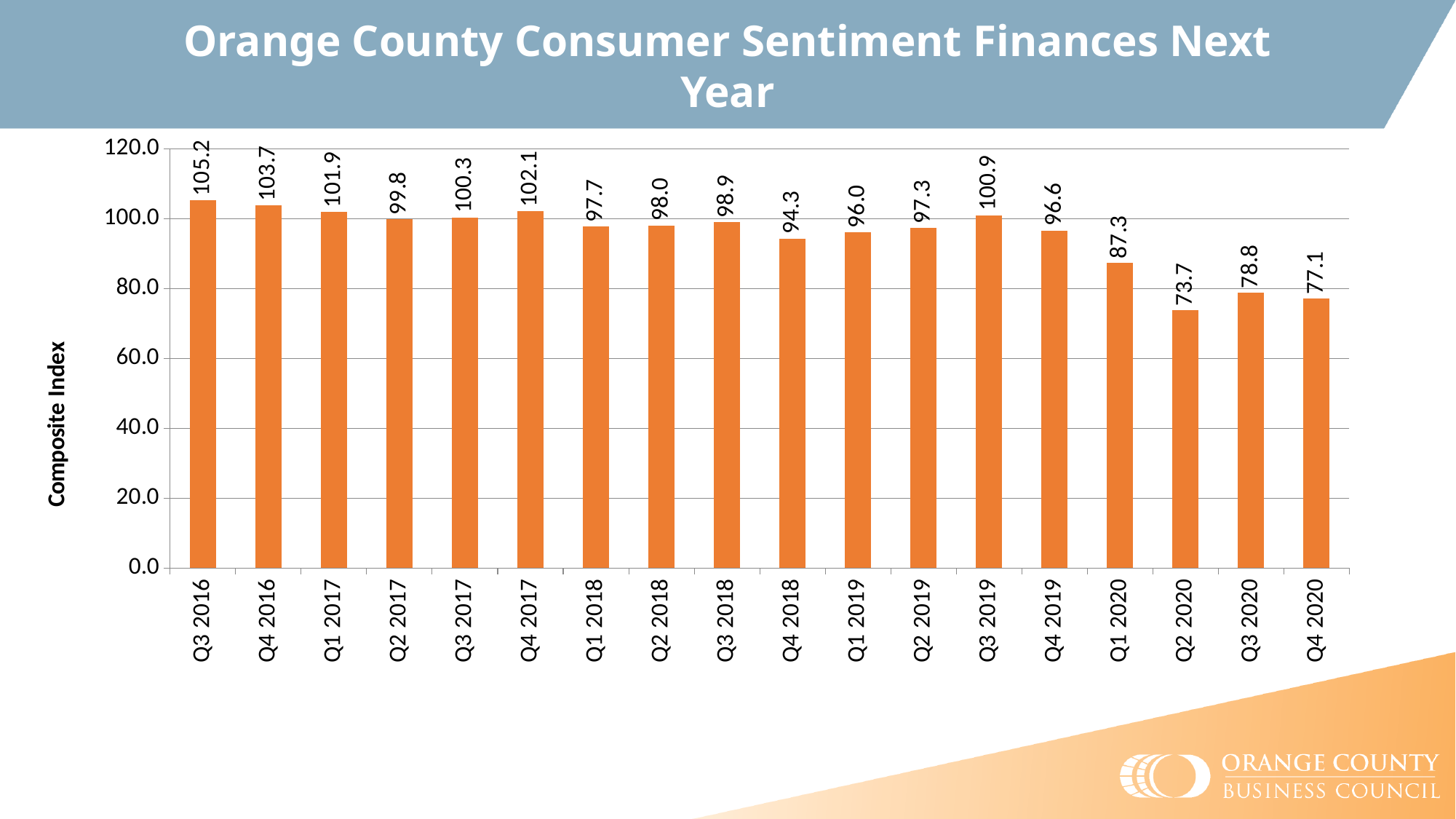
What is the composite index value for Q3 2016? 105.2 Do the composite index values generally rise or fall from Q3 2016 to Q4 2020? Fall Which quarter has the lowest composite index value? Q2 2020 What is the composite index value for Q2 2020? 73.7 How many quarters are shown on the chart? 18 What is the composite index value for Q3 2019? 100.9 What is the title of the chart? Orange County Consumer Sentiment Finances Next Year What kind of chart is shown on the slide? Bar chart Which quarter has the highest composite index value? Q3 2016 Which is larger, the composite index value for Q3 2020 or Q4 2020? Q3 2020 What is the difference between the composite index values for Q1 2020 and Q2 2020? 13.6 What is the composite index value for Q4 2020? 77.1